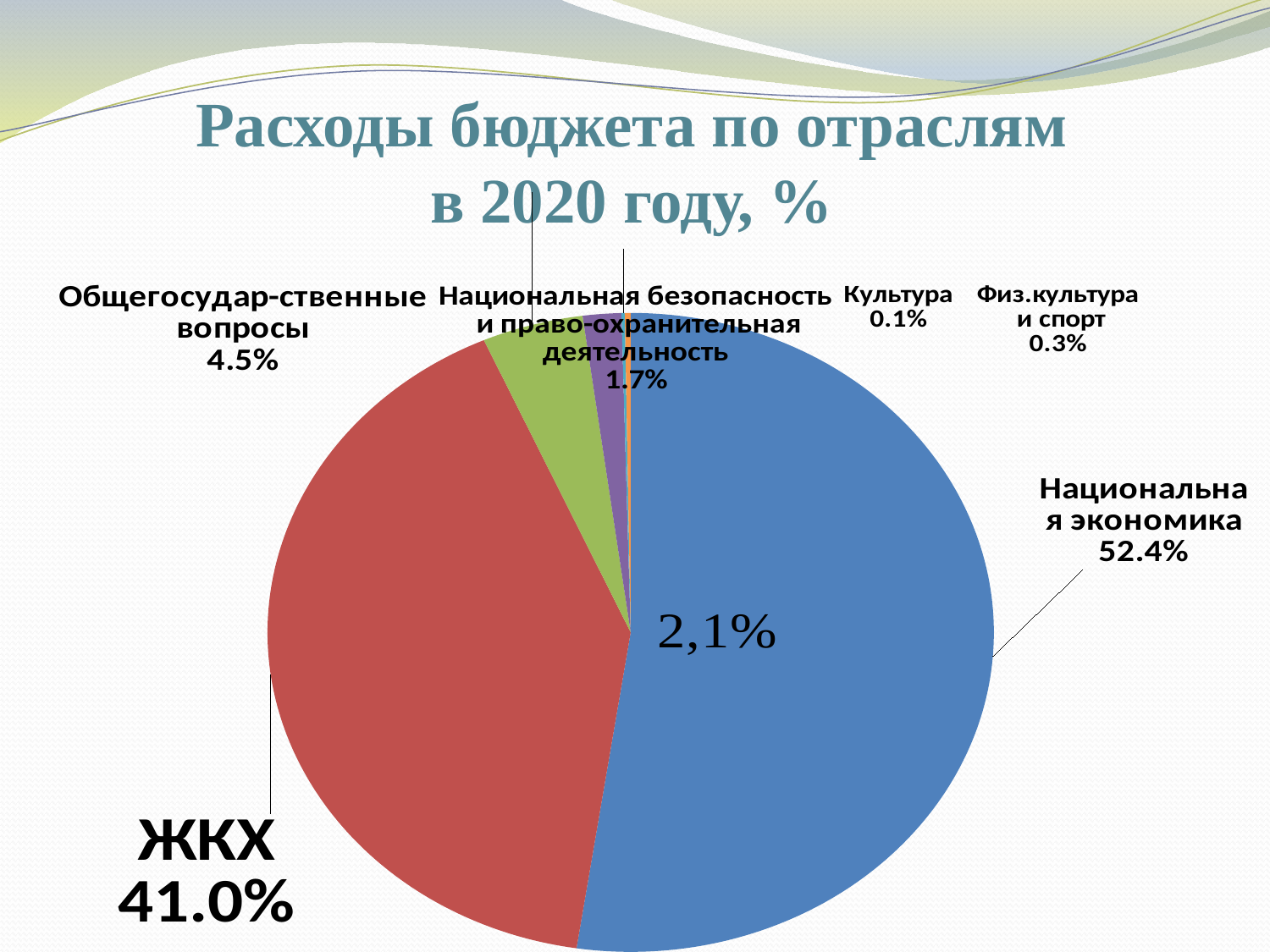
What is the value for Общегосударственные вопросы? 4.5% What is the title of the chart? Расходы бюджета по отраслям в 2020 году, % What is the difference between the shares of Национальная экономика and ЖКХ? 11.4% What is the value for Культура? 0.1% What kind of chart is shown on the slide? pie chart What share of budget expenditure goes to Национальная экономика? 52.4% Which sector has the smallest share of budget expenditure? Культура Which is larger, the share for Общегосударственные вопросы or for Национальная безопасность и правоохранительная деятельность? Общегосударственные вопросы What is the value for Физ.культура и спорт? 0.3% Which sector has the largest share of budget expenditure? Национальная экономика What share of budget expenditure goes to ЖКХ? 41.0% What is the value for Национальная безопасность и правоохранительная деятельность? 1.7%